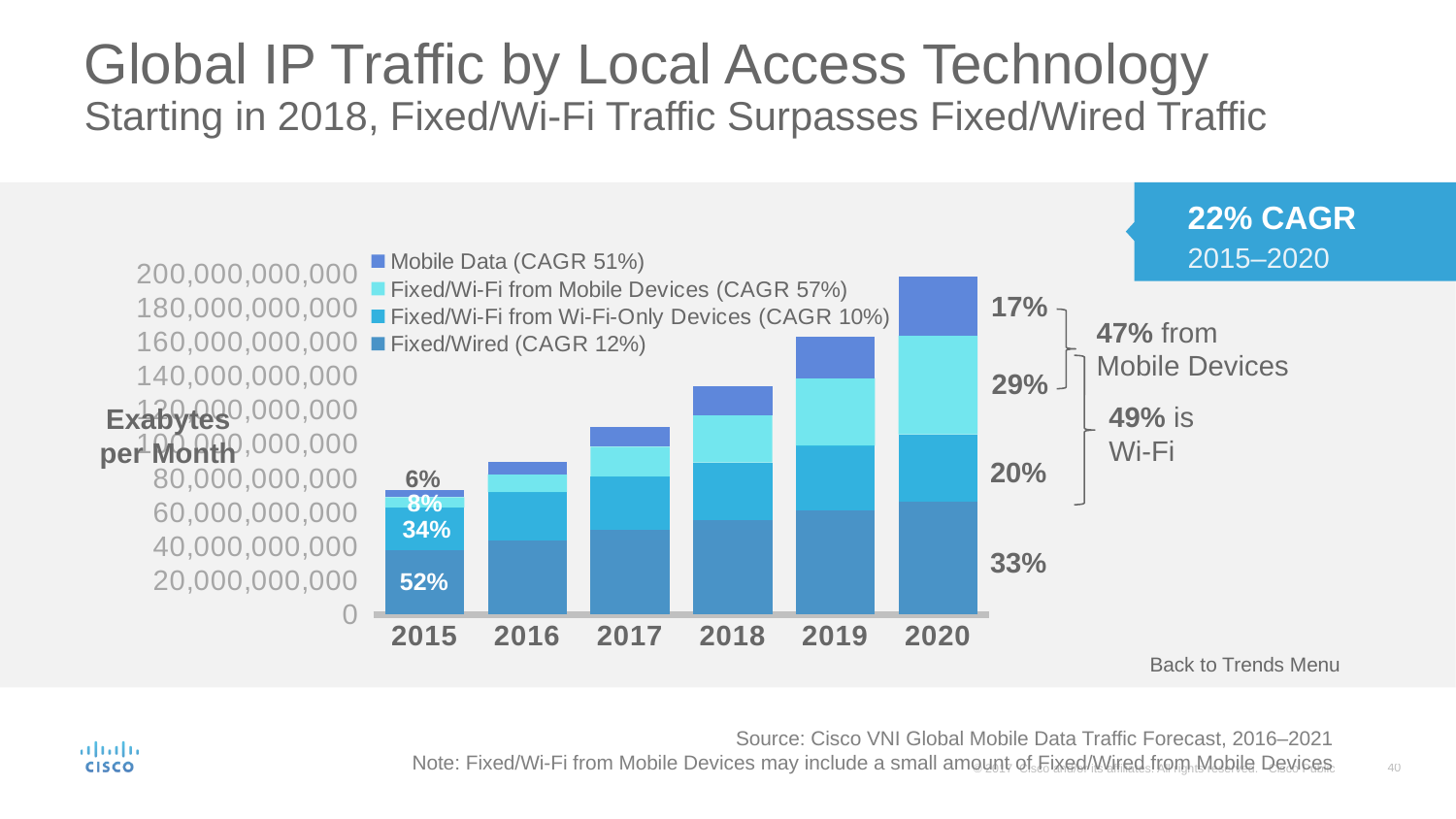
How many series does the chart's legend list? 4 What share of traffic does Mobile Data account for in 2020? 17% What share of traffic does Fixed/Wi-Fi from Mobile Devices account for in 2020? 29% Which year has the tallest total bar? 2020 According to the legend, what is the CAGR for Mobile Data? 51% What share of traffic does Fixed/Wi-Fi from Wi-Fi-Only Devices account for in 2015? 34% Which year has the shortest total bar? 2015 Is the total value for 2020 greater or less than 180,000,000,000? greater What share of traffic does Fixed/Wired account for in 2015? 52% What kind of chart is shown on the slide? Stacked bar chart How many years are shown along the x axis of the chart? 6 By how many percentage points does the Fixed/Wired share fall from 2015 to 2020? 19 percentage points